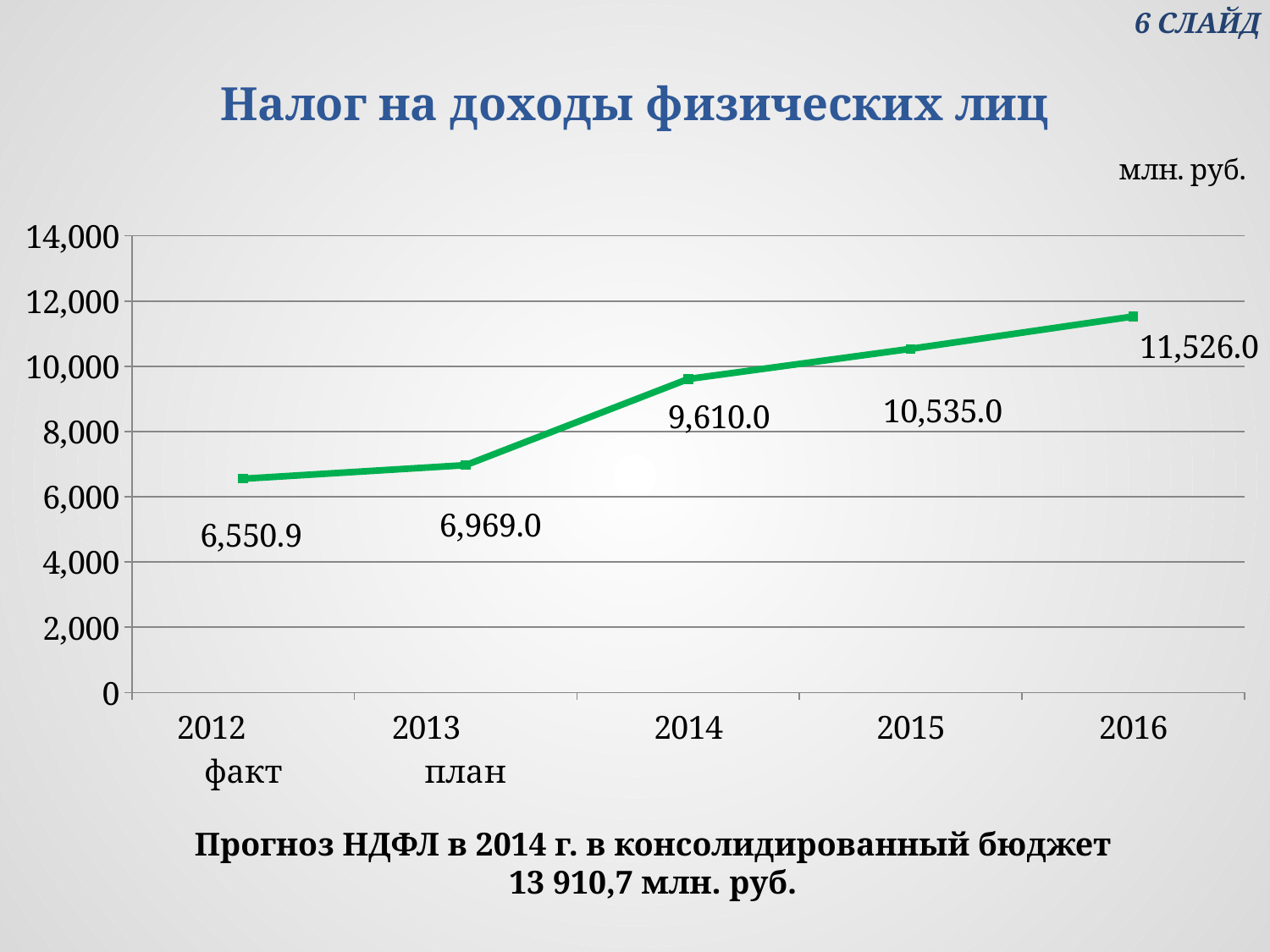
Which year has the lowest value? 2012 What is the value for 2014? 9,610.0 What is the value for 2016? 11,526.0 Which year has the highest value? 2016 What is the difference between the values for 2016 and 2012? 4,975.1 Do the values rise or fall from 2012 to 2016? rise What is the value for 2012? 6,550.9 How many years are plotted on the chart? 5 Which is larger, the value for 2015 or the value for 2014? 2015 Is the value for 2013 greater or less than 8,000? less What is the difference between the values for 2014 and 2013? 2,641.0 What kind of chart is shown on the slide? line chart